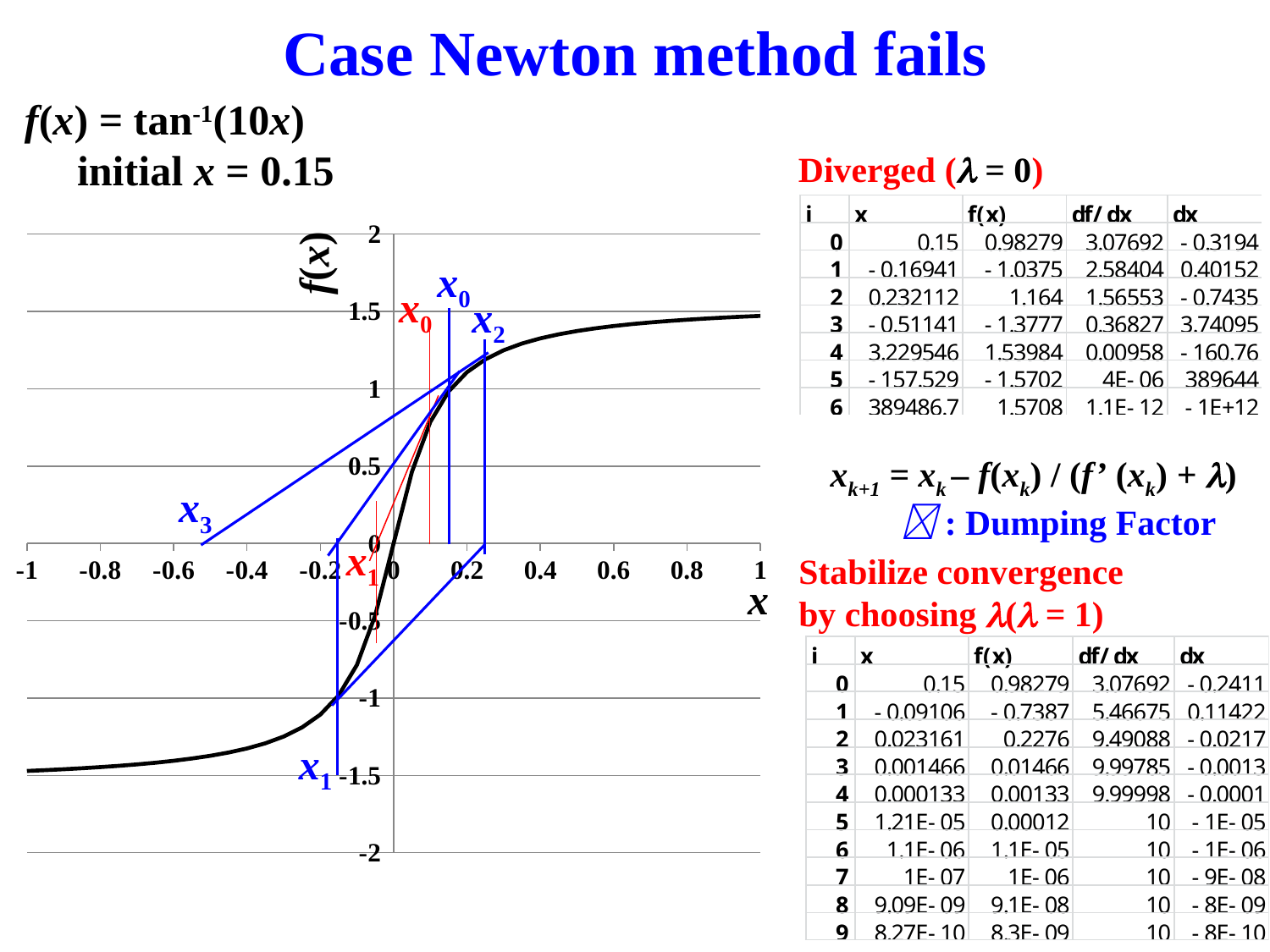
Is the value of f(x) at x = -0.4 greater or less than -1? less What kind of chart is shown on the slide? line chart Does the plotted curve f(x) rise or fall as x increases from -1 to 1? rise How many tick labels are shown on the x axis of the chart? 11 What function is plotted in the chart? f(x) = tan^-1(10x) Is the value of f(x) at x = -1 greater or less than -1? less Is the value of f(x) at x = 0 greater or less than 0.5? less Which is larger, f(x) at x = 0.8 or f(x) at x = -0.8? x = 0.8 What are the labels of the x axis and the y axis of the chart? x and f(x)